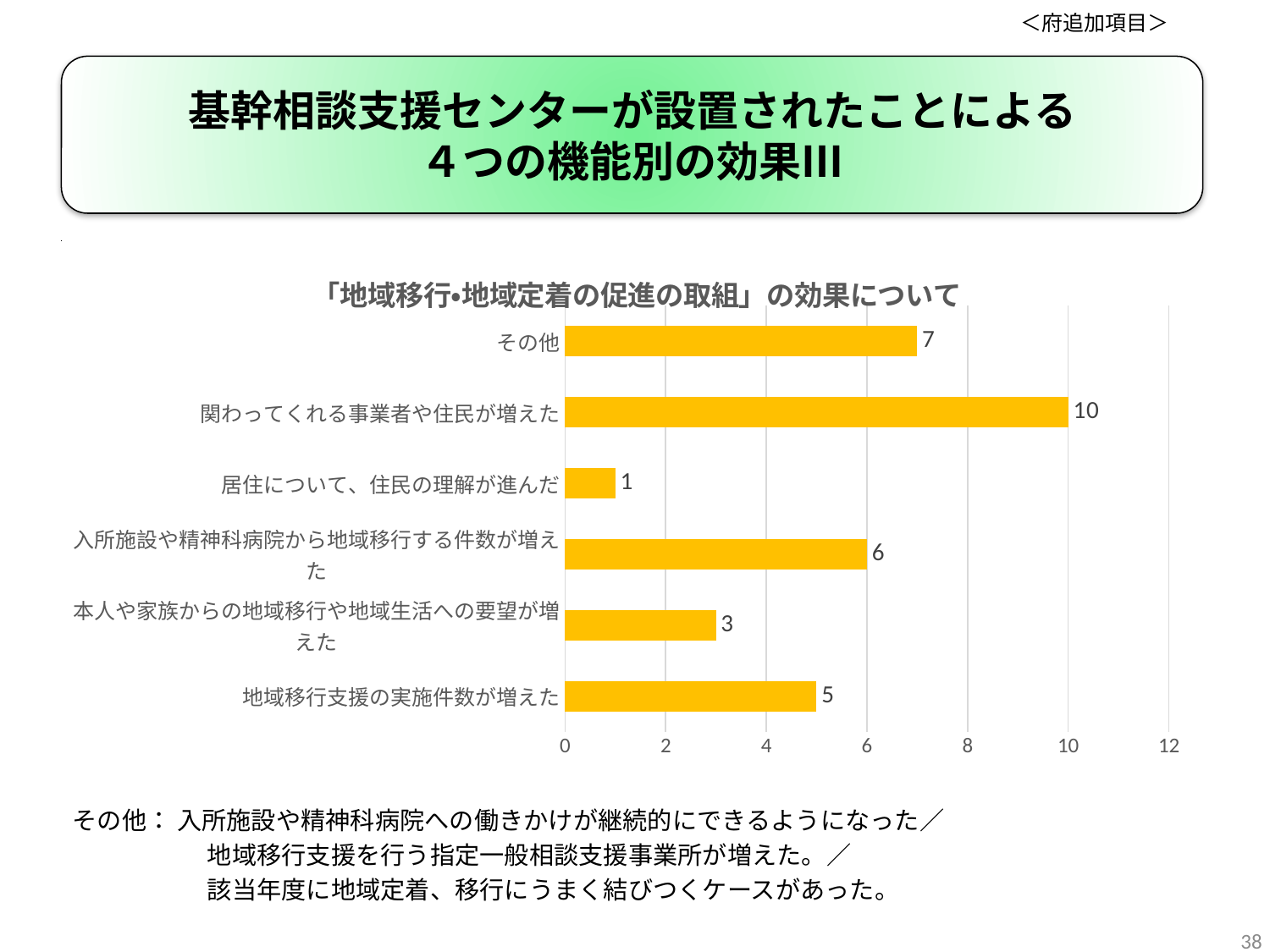
Which category has the lowest value? 居住について、住民の理解が進んだ What is the value for 本人や家族からの地域移行や地域生活への要望が増えた? 3 What is the value for 地域移行支援の実施件数が増えた? 5 Which is larger, the value for その他 or the value for 地域移行支援の実施件数が増えた? その他 What is the value for その他? 7 What is the title of the chart? 「地域移行•地域定着の促進の取組」の効果について Which category has the highest value? 関わってくれる事業者や住民が増えた How many categories are shown in the chart? 6 What is the value for 関わってくれる事業者や住民が増えた? 10 What is the difference between the values for 関わってくれる事業者や住民が増えた and 入所施設や精神科病院から地域移行する件数が増えた? 4 Is the value for 入所施設や精神科病院から地域移行する件数が増えた greater or less than 4? greater What kind of chart is shown on the slide? bar chart